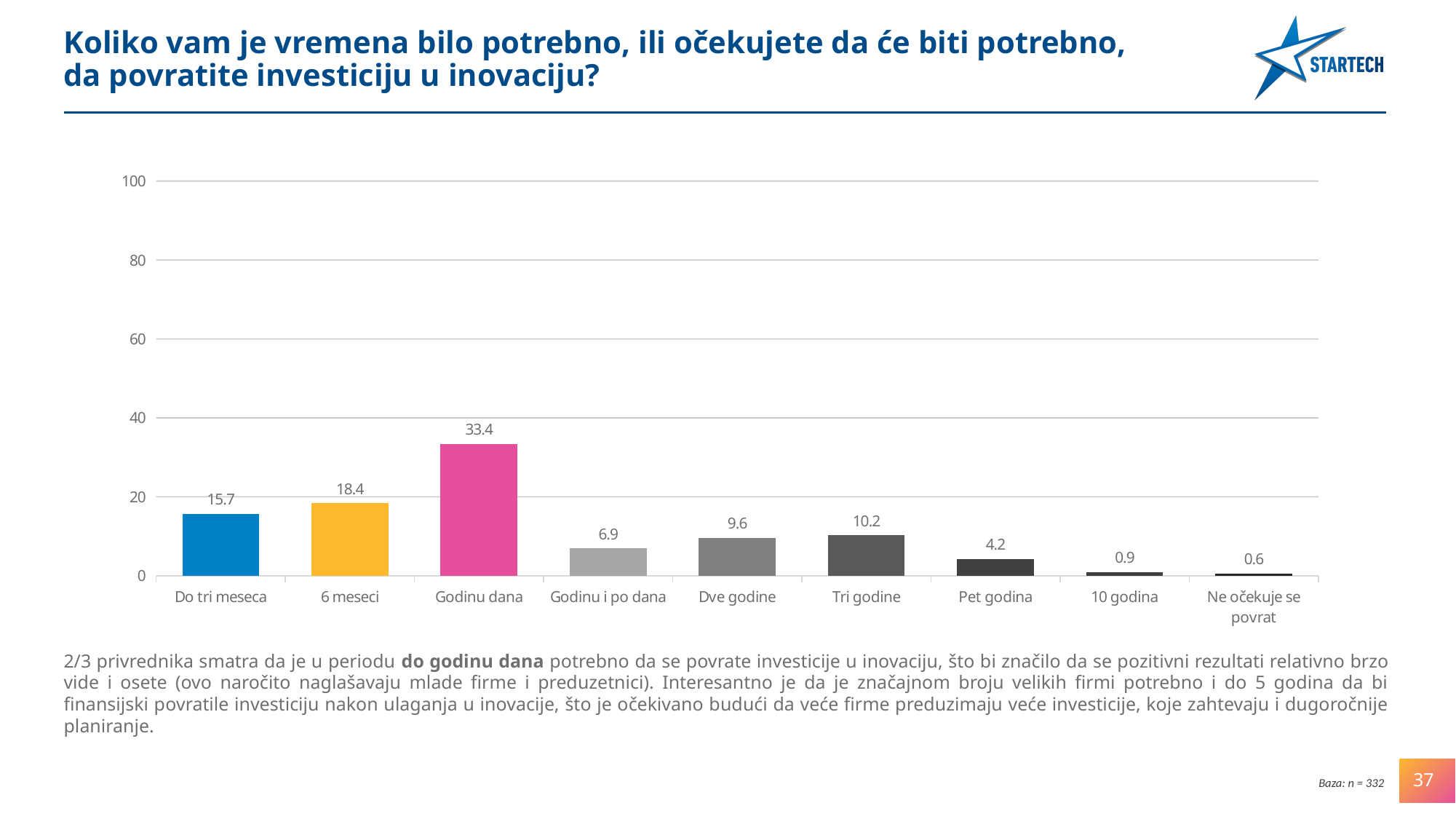
What is the difference between the values for "Godinu dana" and "6 meseci"? 15 What colour is the bar for "Godinu dana"? pink What kind of chart is shown on the slide? bar chart Is the value for "Godinu dana" greater or less than 40? less What is the value for "Godinu dana"? 33.4 Which is larger, the value for "Dve godine" or the value for "Tri godine"? Tri godine What is the value for "Pet godina"? 4.2 How many categories are shown on the x axis? 9 Which category has the highest value? Godinu dana What is the value for "10 godina"? 0.9 Which category has the lowest value? Ne očekuje se povrat What is the value for "Do tri meseca"? 15.7